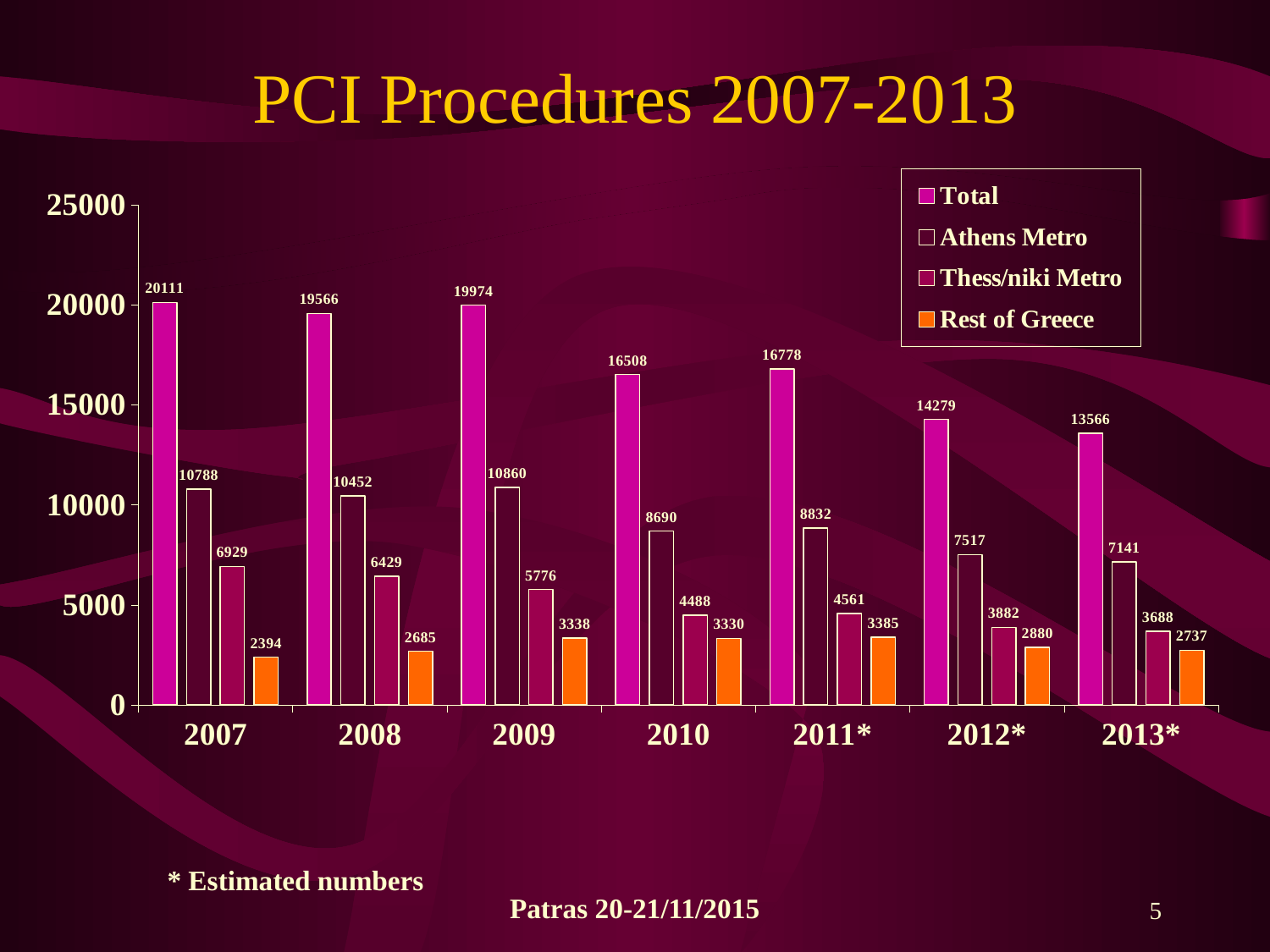
What kind of chart is shown on the slide? bar chart How many years are shown on the x axis? 7 Which is larger, the Athens Metro value for 2009 or for 2008? 2009 What is the Total value for 2007? 20111 Which year has the lowest Rest of Greece value? 2007 How many series does the legend list? 4 What is the difference between the Total values for 2007 and 2013*? 6545 What is the Athens Metro value for 2010? 8690 Which year has the highest Total value? 2007 What is the Thess/niki Metro value for 2011*? 4561 Is the Total value for 2012* greater or less than 15000? less What is the Rest of Greece value for 2013*? 2737